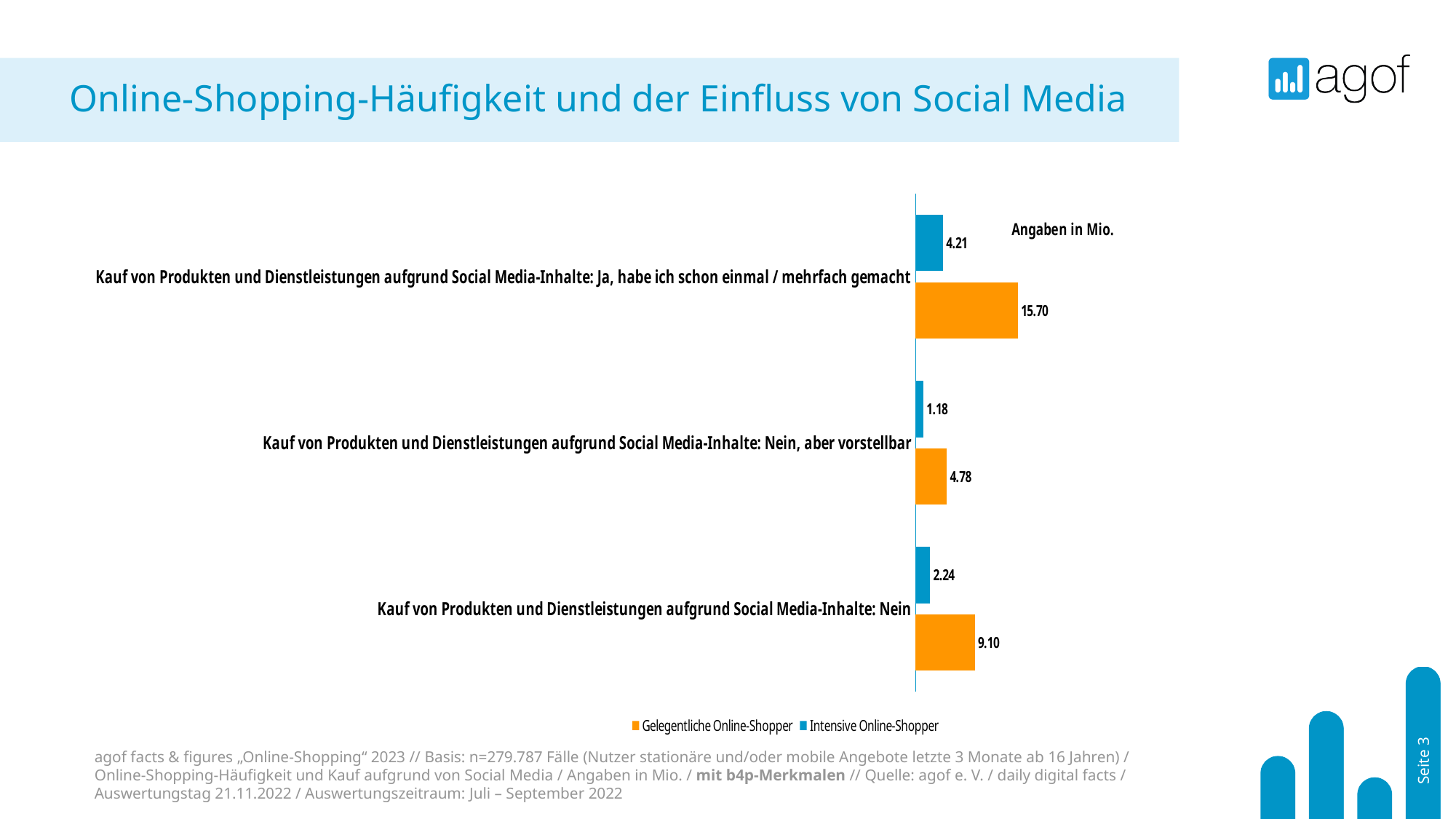
What is the value for Gelegentliche Online-Shopper in the category "Kauf von Produkten und Dienstleistungen aufgrund Social Media-Inhalte: Nein"? 9.10 Which category has the highest value for Gelegentliche Online-Shopper? Kauf von Produkten und Dienstleistungen aufgrund Social Media-Inhalte: Ja, habe ich schon einmal / mehrfach gemacht How many categories are shown in the chart? 3 What is the value for Intensive Online-Shopper in the category "Kauf von Produkten und Dienstleistungen aufgrund Social Media-Inhalte: Nein"? 2.24 How many series does the legend list? 2 Which is larger: the Gelegentliche Online-Shopper value for "Nein, aber vorstellbar" or the Intensive Online-Shopper value for "Ja, habe ich schon einmal / mehrfach gemacht"? Gelegentliche Online-Shopper value for "Nein, aber vorstellbar" (4.78) What unit are the values given in, according to the note on the chart? Mio. Which category has the lowest value for Intensive Online-Shopper? Kauf von Produkten und Dienstleistungen aufgrund Social Media-Inhalte: Nein, aber vorstellbar What is the difference between Gelegentliche Online-Shopper and Intensive Online-Shopper in the category "Kauf von Produkten und Dienstleistungen aufgrund Social Media-Inhalte: Ja, habe ich schon einmal / mehrfach gemacht"? 11.49 What is the value for Intensive Online-Shopper in the category "Kauf von Produkten und Dienstleistungen aufgrund Social Media-Inhalte: Nein, aber vorstellbar"? 1.18 What kind of chart is shown on the slide? Bar chart What is the value for Gelegentliche Online-Shopper in the category "Kauf von Produkten und Dienstleistungen aufgrund Social Media-Inhalte: Ja, habe ich schon einmal / mehrfach gemacht"? 15.70